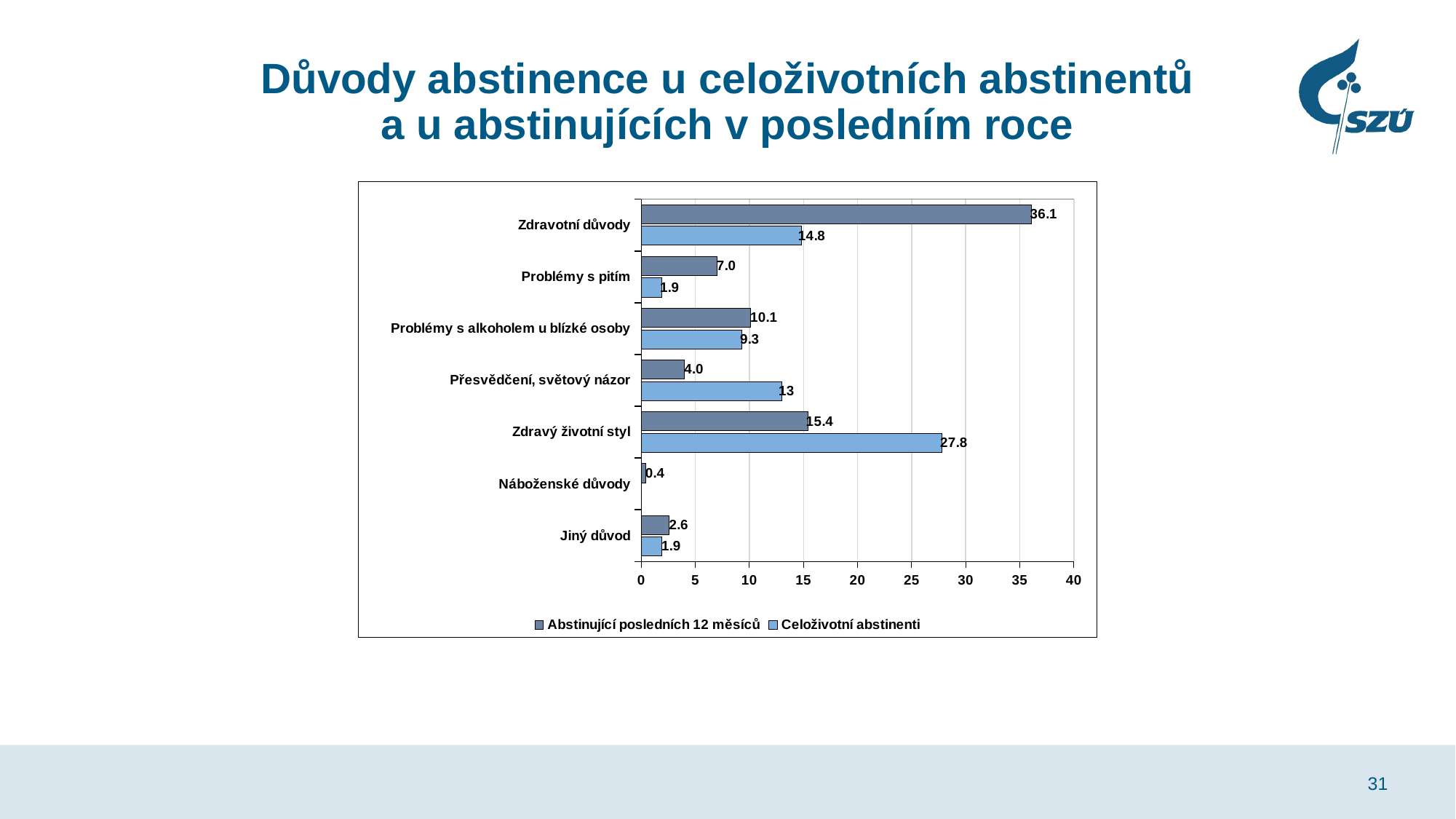
What type of chart is shown on the slide? bar chart Is the value for Zdravotní důvody in the Abstinující posledních 12 měsíců series greater or less than 35? greater What is the value for Zdravý životní styl in the Celoživotní abstinenti series? 27.8 How many categories are shown on the chart? 7 Which series is shown in the darker blue colour? Abstinující posledních 12 měsíců What is the value for Přesvědčení, světový názor in the Celoživotní abstinenti series? 13 Which category has the lowest value in the Abstinující posledních 12 měsíců series? Náboženské důvody How many series does the legend list? 2 What is the difference between the two series for Zdravotní důvody? 21.3 Which category has the highest value in the Abstinující posledních 12 měsíců series? Zdravotní důvody What is the value for Zdravotní důvody in the Abstinující posledních 12 měsíců series? 36.1 For Zdravý životní styl, which series has the larger value? Celoživotní abstinenti